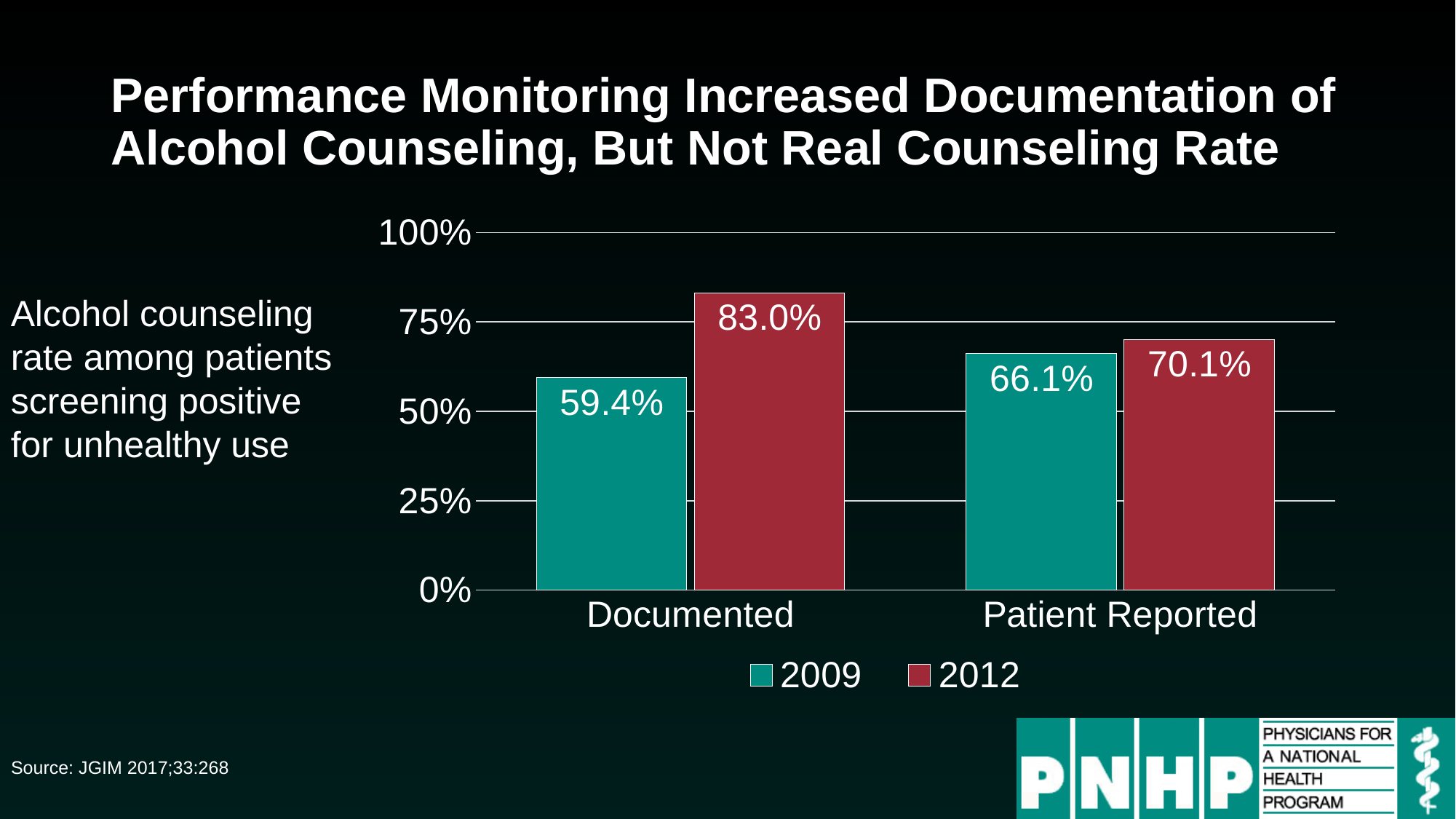
How many categories are shown on the x axis? 2 Which category has the highest 2012 value? Documented What is the difference between the 2012 and 2009 values for Patient Reported? 4.0% What is the 2012 value for Documented? 83.0% Which category has the lowest 2009 value? Documented What is the 2009 value for Patient Reported? 66.1% What is the difference between the 2012 and 2009 values for Documented? 23.6% What is the 2012 value for Patient Reported? 70.1% How many series does the legend list? 2 What is the 2009 value for Documented? 59.4% Which is larger: the 2009 value for Patient Reported or the 2009 value for Documented? Patient Reported What kind of chart is shown on the slide? Bar chart